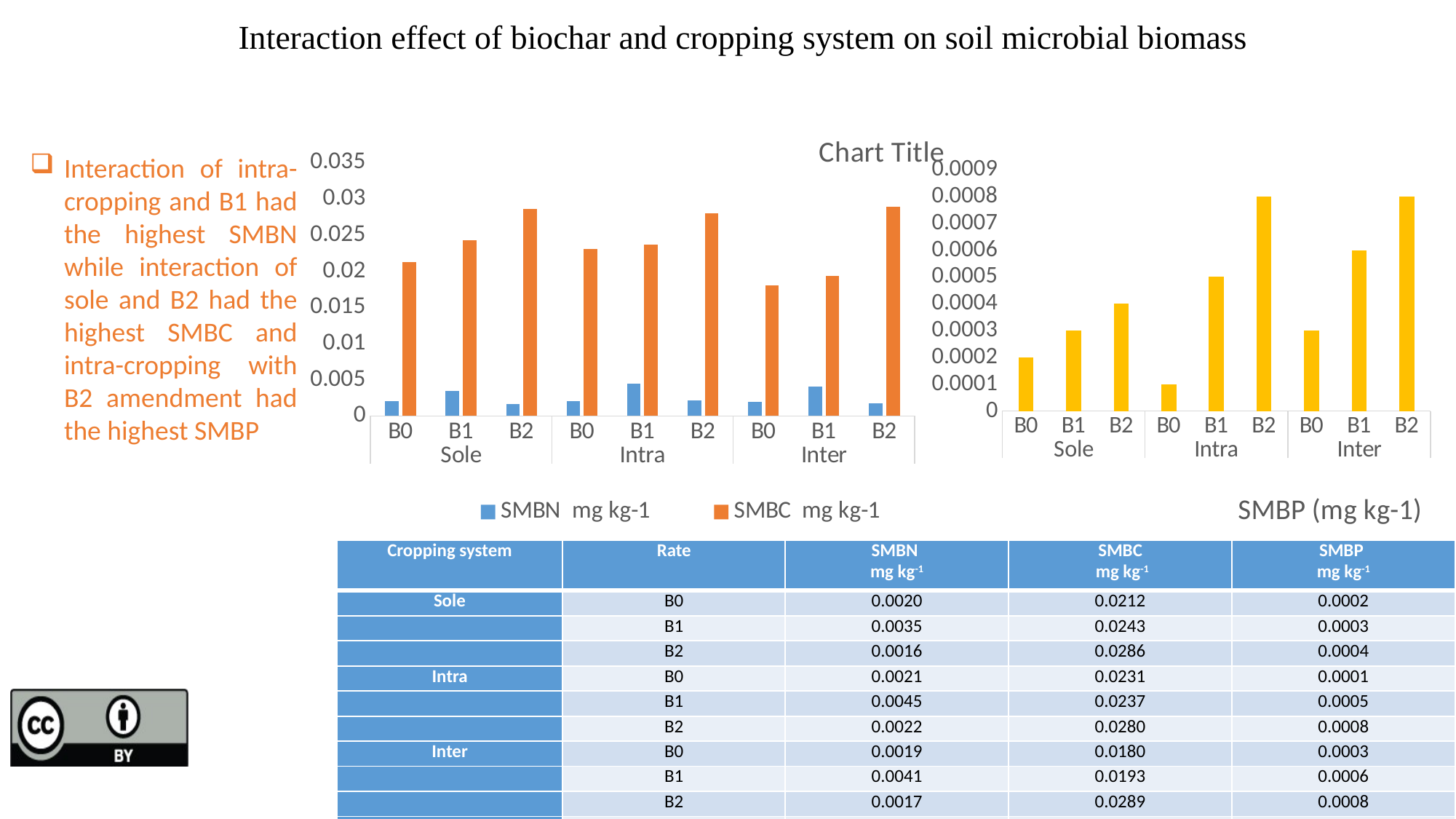
In the left-hand chart (Chart Title), is the SMBC value for B2 under Sole greater or less than 0.025? greater What kind of chart is the right-hand chart (SMBP)? bar chart In the right-hand chart (SMBP), do the values rise or fall from B0 to B2 within the Sole group? rise How many series does the legend of the left-hand chart (Chart Title) list? 2 In the right-hand chart (SMBP), what is the difference between B2 under Intra and B0 under Intra? 0.0007 In the right-hand chart (SMBP), what is the value for B0 under Sole? 0.0002 How many category groups (bar positions) are shown along the x axis of the left-hand chart (Chart Title)? 9 In the right-hand chart (SMBP), what is the value for B2 under Intra? 0.0008 In the right-hand chart (SMBP), which bar is the lowest? B0 under Intra In the left-hand chart (Chart Title), which series has the larger values overall, SMBN or SMBC? SMBC In the right-hand chart (SMBP), which is larger: B1 under Intra or B1 under Inter? B1 under Inter In the left-hand chart (Chart Title), is the SMBC value for B0 under Inter greater or less than 0.02? less